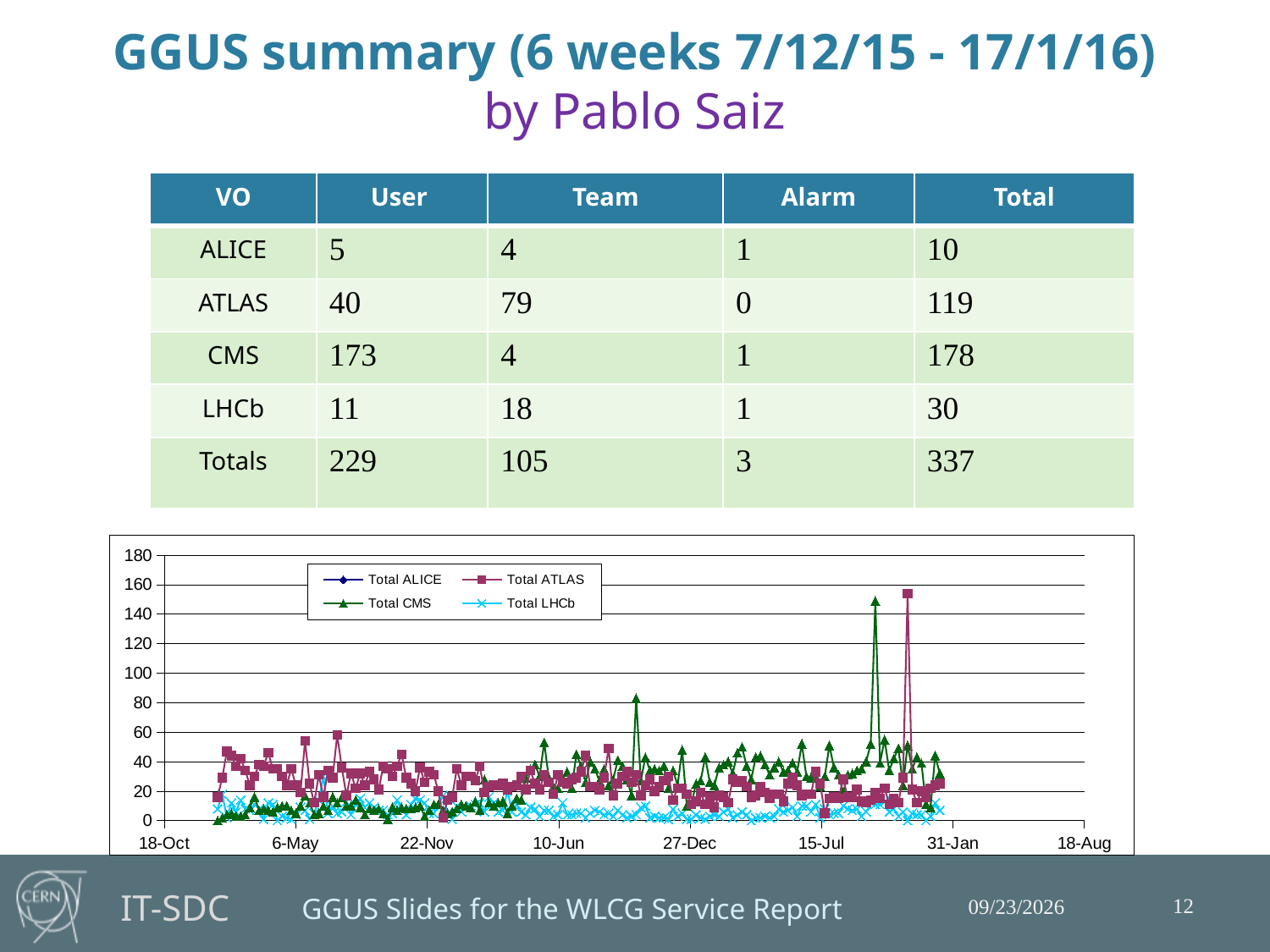
Is the highest peak of the Total LHCb series greater or less than 60? less Is the highest peak of the Total CMS series greater or less than 120? greater Which series has the lowest values across most of the chart, Total LHCb or Total CMS? Total LHCb Which series are listed in the chart's legend? Total ALICE, Total ATLAS, Total CMS, Total LHCb What is the highest value shown on the chart's vertical axis? 180 Is the highest peak of the Total ALICE series greater or less than 60? less What is the first date label on the chart's horizontal axis? 18-Oct What kind of chart is shown at the bottom of the slide? line chart How many series does the legend of the chart list? 4 Which series reaches a higher peak, Total CMS or Total LHCb? Total CMS